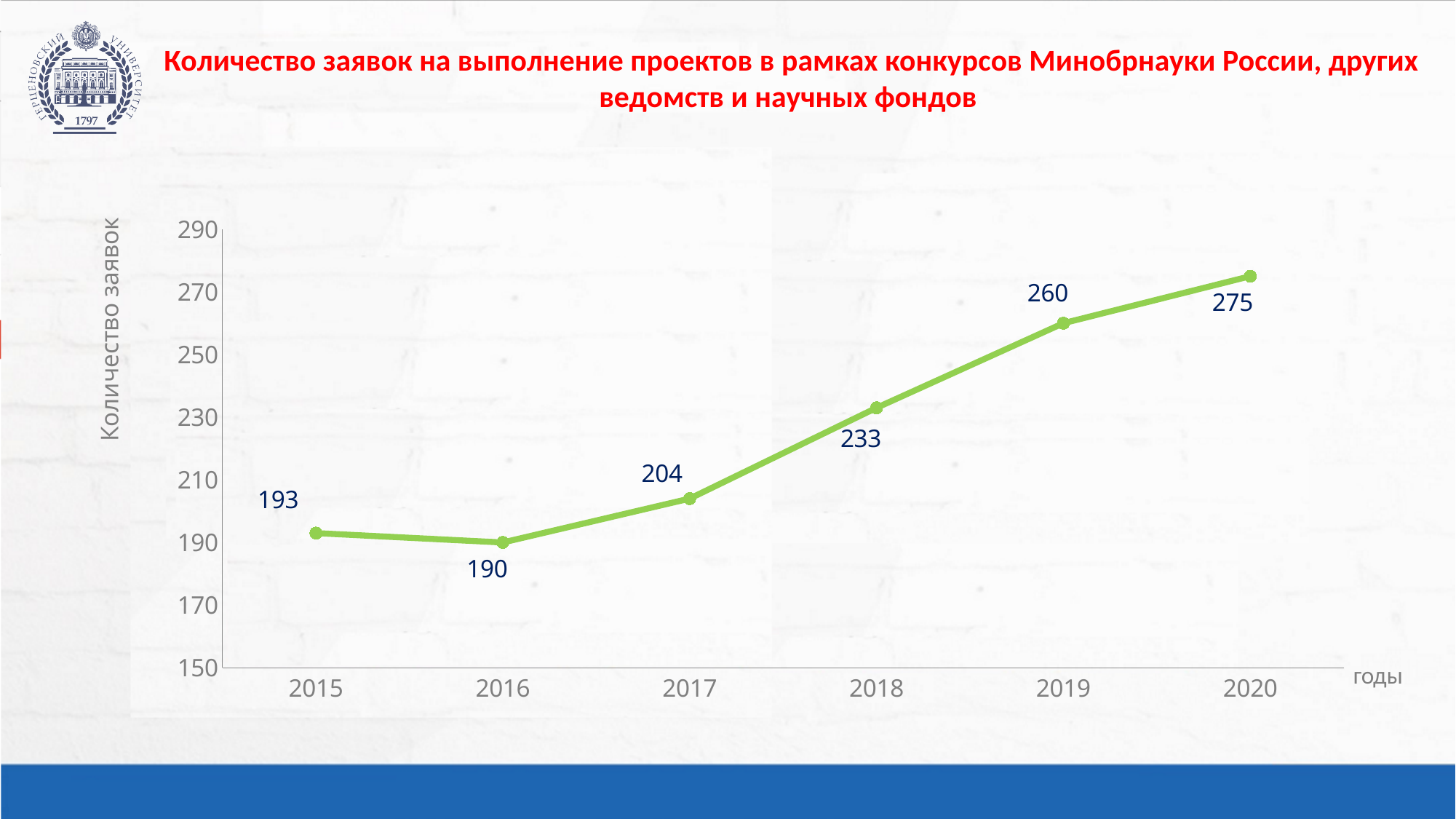
How many years are plotted on the chart? 6 What is the difference between the number of applications in 2019 and in 2017? 56 Which year has the lowest number of applications? 2016 What is the difference between the number of applications in 2020 and in 2015? 82 Which year has the highest number of applications? 2020 Is the value for 2019 greater or less than 250? greater What is the number of applications in 2015? 193 What is the overall trend of the number of applications from 2016 to 2020? rising What is the number of applications in 2020? 275 What kind of chart is shown on the slide? line chart What is the number of applications in 2018? 233 Which year has more applications, 2016 or 2017? 2017